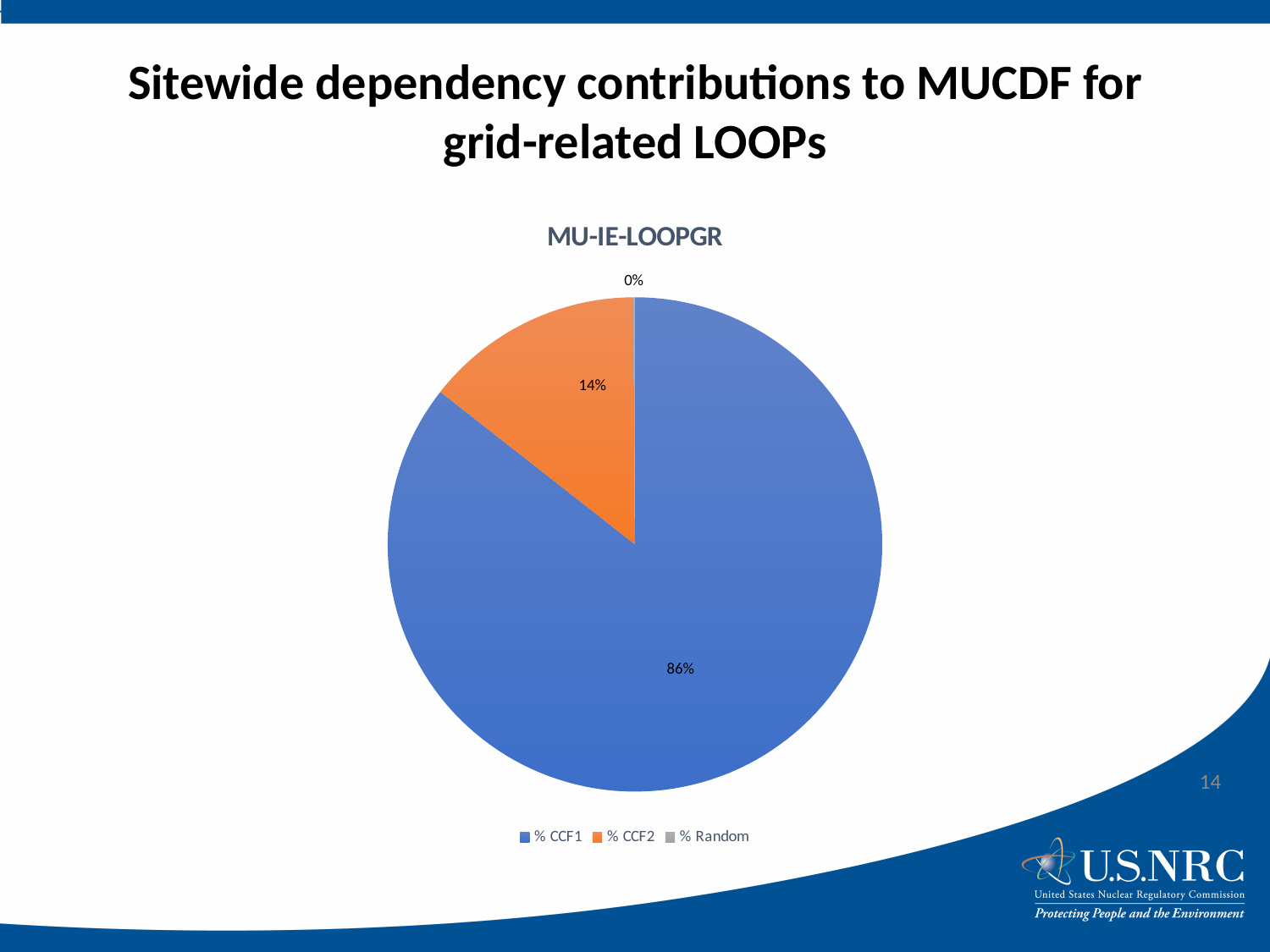
Which is larger, the % CCF2 slice or the % Random slice? % CCF2 What colour is the % CCF2 slice? orange Which category has the smallest slice of the pie? % Random How many categories does the legend list? 3 What kind of chart is shown on the slide? pie chart What share of the pie does % CCF2 represent? 14% What share of the pie does % CCF1 represent? 86% What is the difference in percentage points between the % CCF1 and % CCF2 slices? 72 What share of the pie does % Random represent? 0% Which category has the largest slice of the pie? % CCF1 What is the title of the chart? MU-IE-LOOPGR